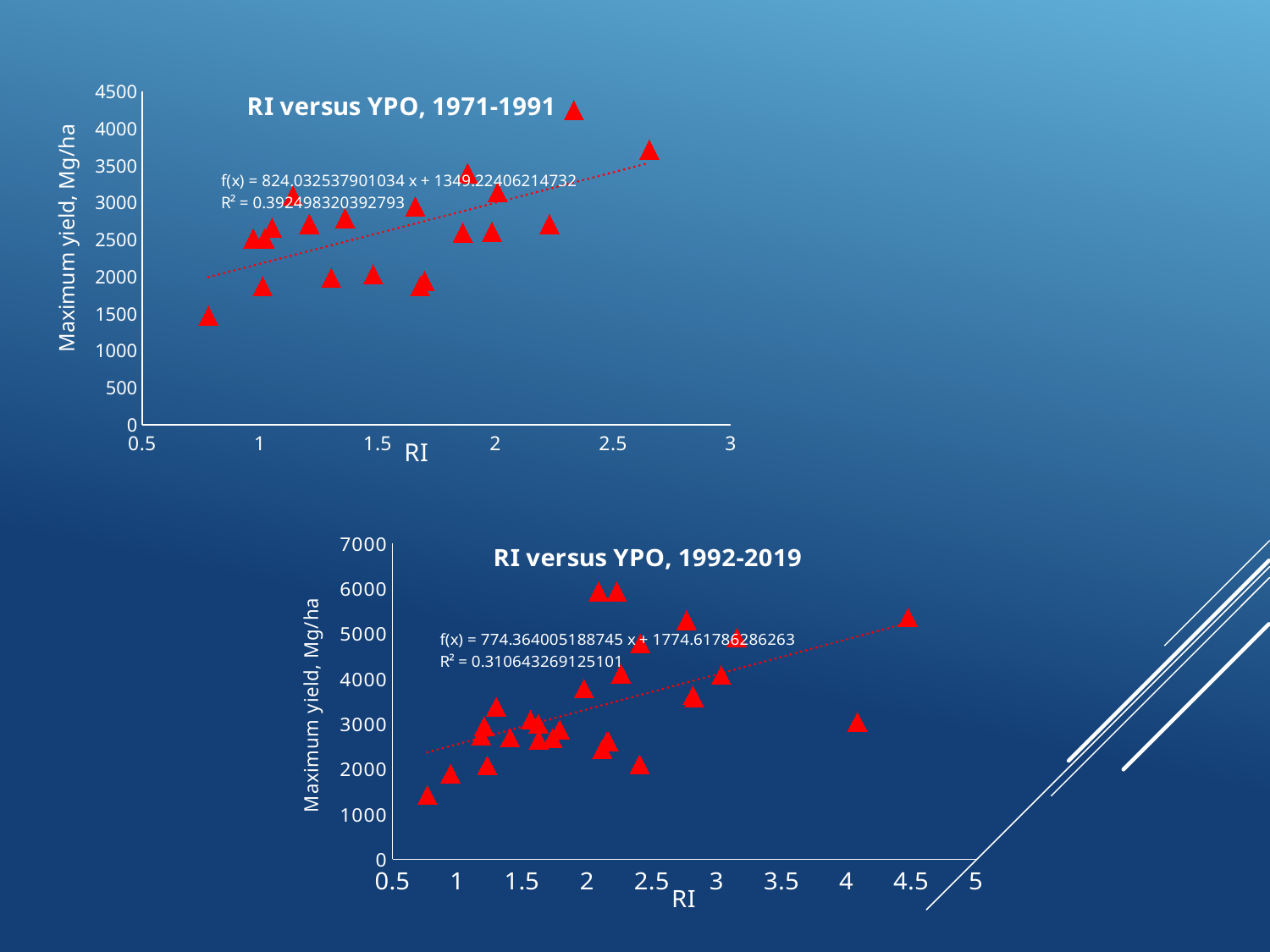
In the bottom chart 'RI versus YPO, 1992-2019', is the lowest plotted maximum yield greater or less than 2000? less What is the trend line equation shown on the top chart 'RI versus YPO, 1971-1991'? f(x) = 824.032537901034 x + 1349.22406214732 In the top chart 'RI versus YPO, 1971-1991', is the highest plotted maximum yield greater or less than 4000? greater What is the y-axis title of the top chart 'RI versus YPO, 1971-1991'? Maximum yield, Mg/ha What is the trend line equation shown on the bottom chart 'RI versus YPO, 1992-2019'? f(x) = 774.364005188745 x + 1774.61786286263 In the bottom chart 'RI versus YPO, 1992-2019', is the highest plotted maximum yield greater or less than 5000? greater What is the R² value shown on the top chart 'RI versus YPO, 1971-1991'? 0.392498320392793 In the bottom chart 'RI versus YPO, 1992-2019', does the fitted trend line rise or fall as RI increases? rises What kind of chart is the top chart titled 'RI versus YPO, 1971-1991'? scatter chart Which chart has the higher R² value, the top chart (1971-1991) or the bottom chart (1992-2019)? the top chart (1971-1991) What is the R² value shown on the bottom chart 'RI versus YPO, 1992-2019'? 0.310643269125101 In the top chart 'RI versus YPO, 1971-1991', does the fitted trend line rise or fall as RI increases? rises